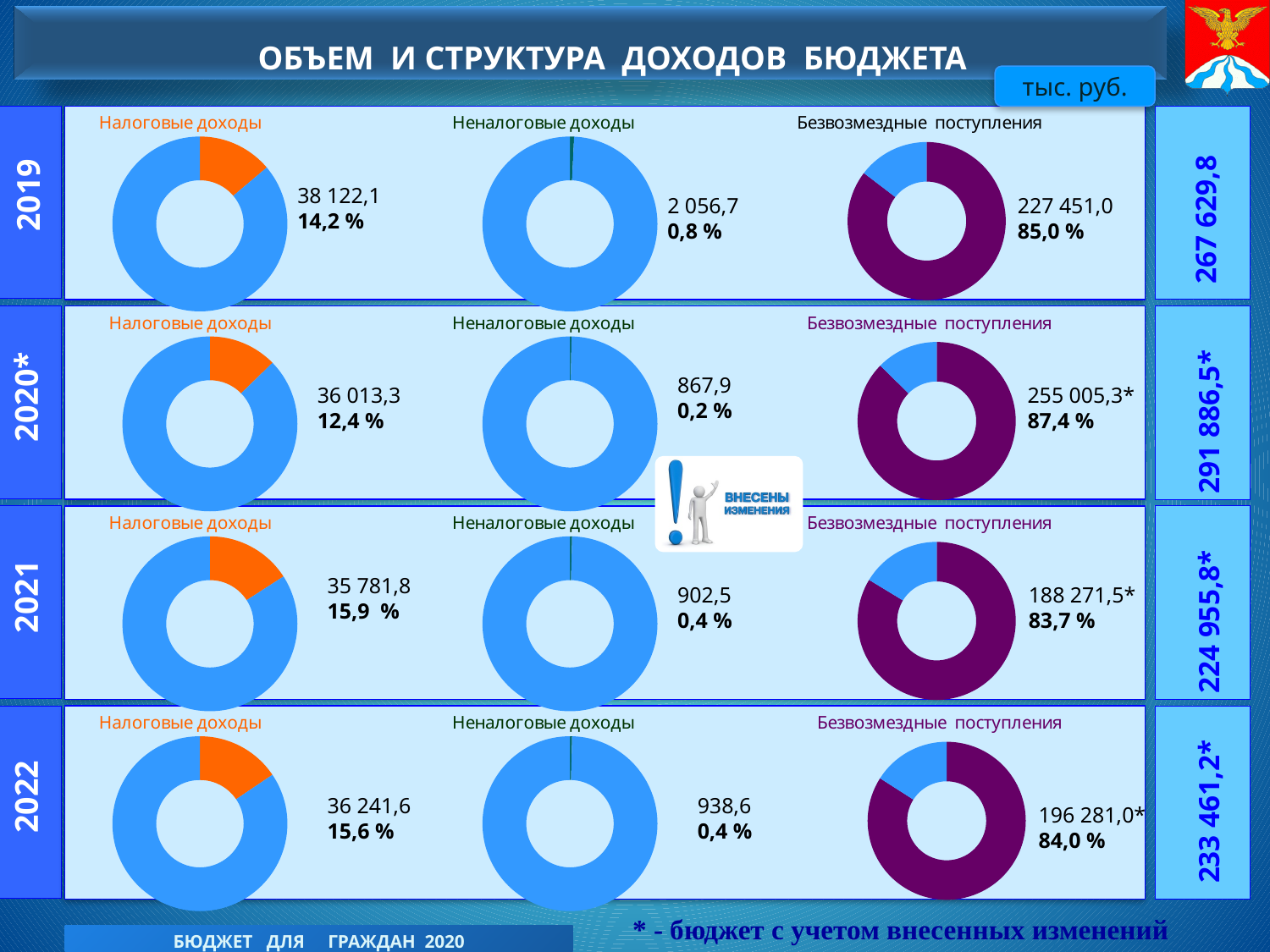
In the 2020* row, what value is shown for 'Неналоговые доходы'? 867,9 What kind of charts are used on this slide? Donut (pie) charts In the 2019 row, which category has the largest share: 'Налоговые доходы', 'Неналоговые доходы' or 'Безвозмездные поступления'? Безвозмездные поступления In the 2021 row, what percentage is shown for 'Налоговые доходы'? 15,9 % In the 2019 row, what value is shown next to the 'Налоговые доходы' donut chart? 38 122,1 In the 2022 row, which category has the smallest share? Неналоговые доходы What total is shown on the right side of the slide for the 2021 row? 224 955,8* Which is larger: the 'Налоговые доходы' value for 2019 or for 2020*? 2019 What is the difference between the 'Неналоговые доходы' values for 2019 and 2020*? 1 188,8 How many donut charts are shown on the slide? 12 In the 2019 row, what percentage is shown for 'Безвозмездные поступления'? 85,0 % In the 2022 row, what value is shown for 'Безвозмездные поступления'? 196 281,0*